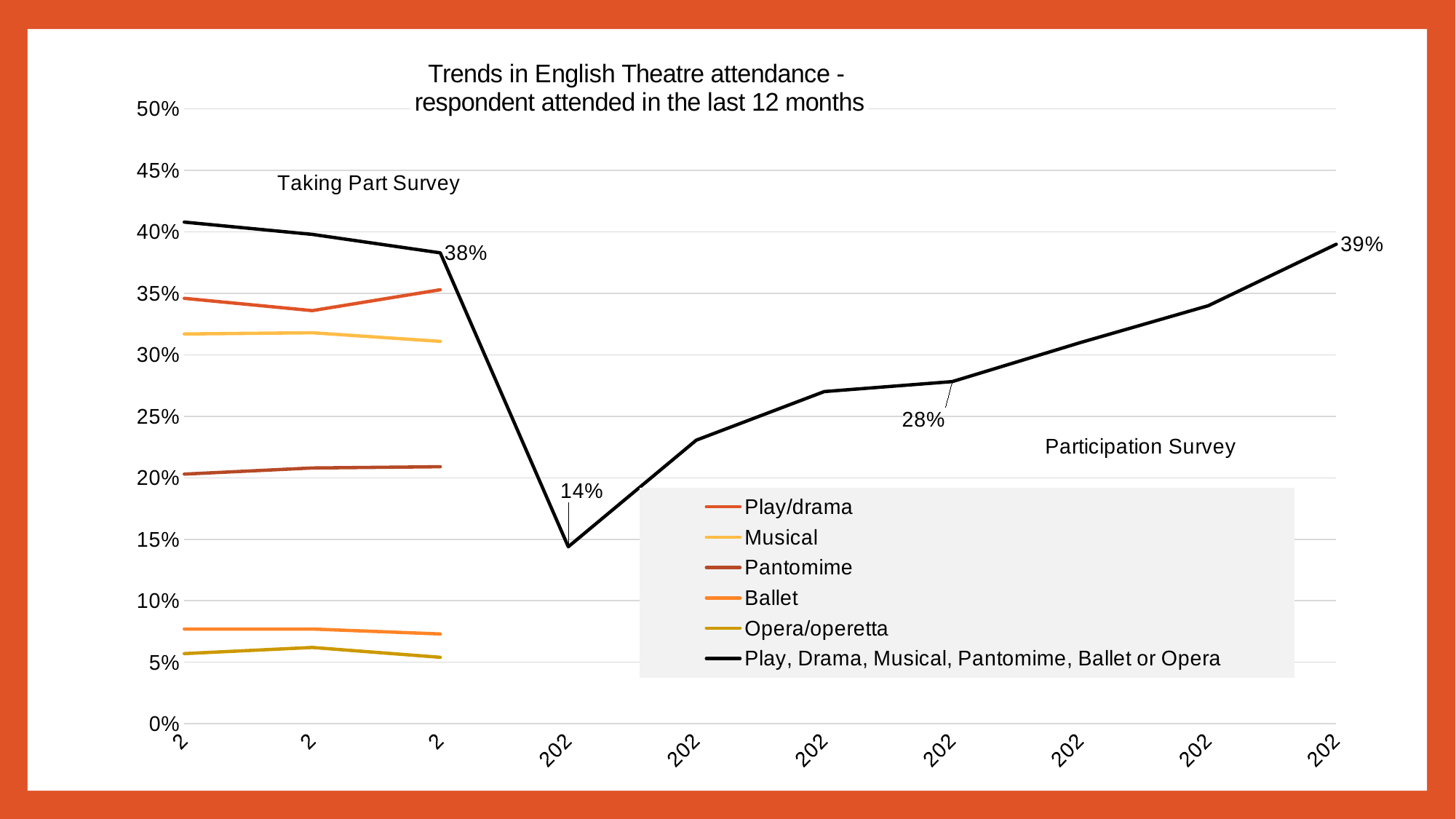
Is the value for the Ballet line greater or less than 10%? less What is the difference between the 38% and 28% labelled values on the black line? 10 percentage points Which line is higher, Play/drama or Musical? Play/drama What kind of chart is shown on the slide? line chart Which line is higher, Ballet or Opera/operetta? Ballet How many series does the legend list? 6 After the 14% low point, do the values on the black line rise or fall along the x axis? rise Is the value for the Musical line greater or less than 35%? less What is the highest labelled value on the black 'Play, Drama, Musical, Pantomime, Ballet or Opera' line? 39% What is the title of the chart? Trends in English Theatre attendance - respondent attended in the last 12 months What is the lowest labelled value on the black 'Play, Drama, Musical, Pantomime, Ballet or Opera' line? 14% What is the difference between the 39% and 14% labelled values on the black line? 25 percentage points